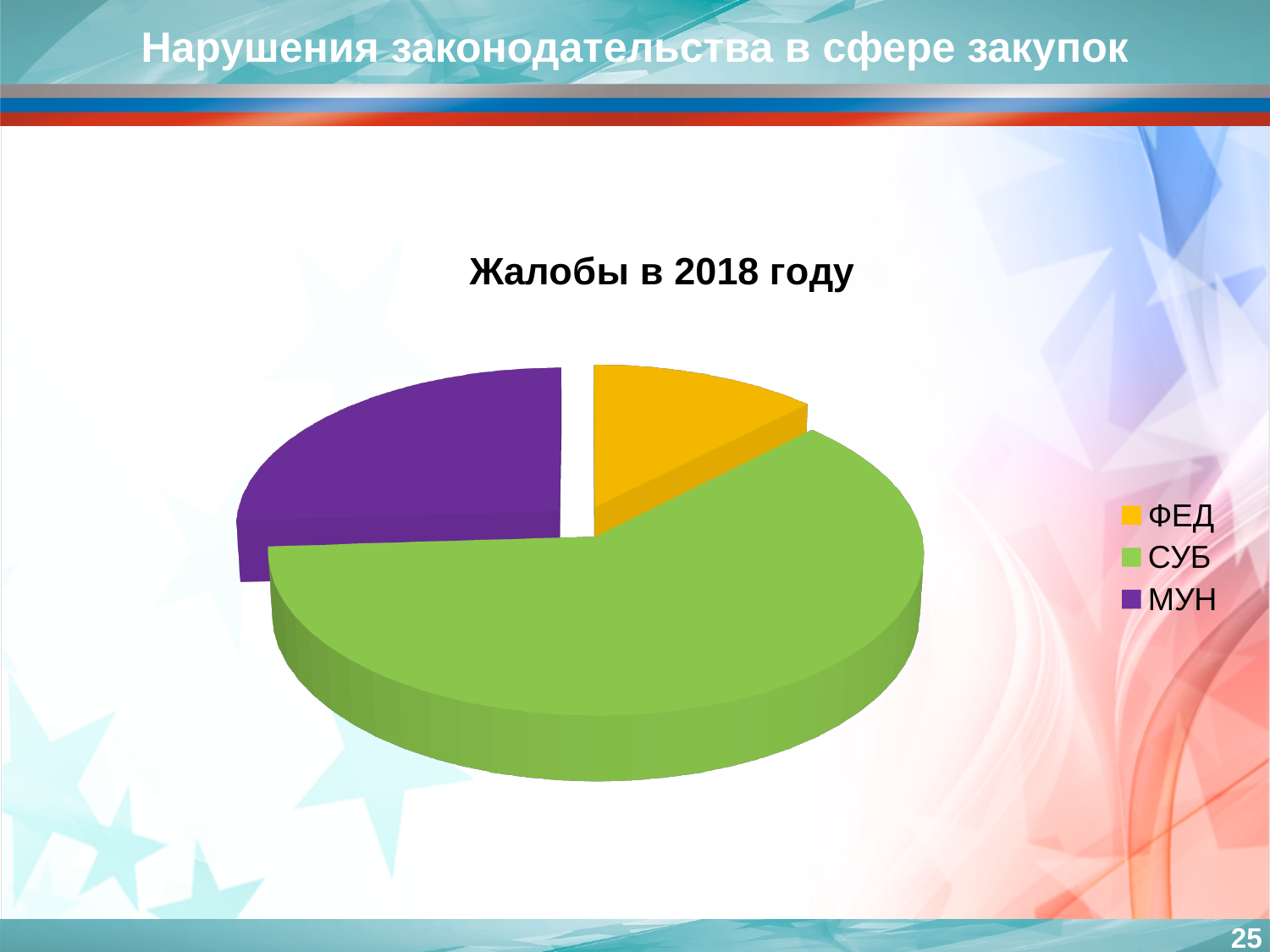
What is the title of the chart? Жалобы в 2018 году Which category has the largest slice of the pie? СУБ How many slices does the pie chart have? 3 Which category is shown in purple? МУН Which slice is larger, СУБ or МУН? СУБ Which slice is larger, МУН or ФЕД? МУН What colour is the СУБ slice in the pie chart? green What kind of chart is shown on the slide? pie chart Which category has the smallest slice of the pie? ФЕД How many entries does the legend list? 3